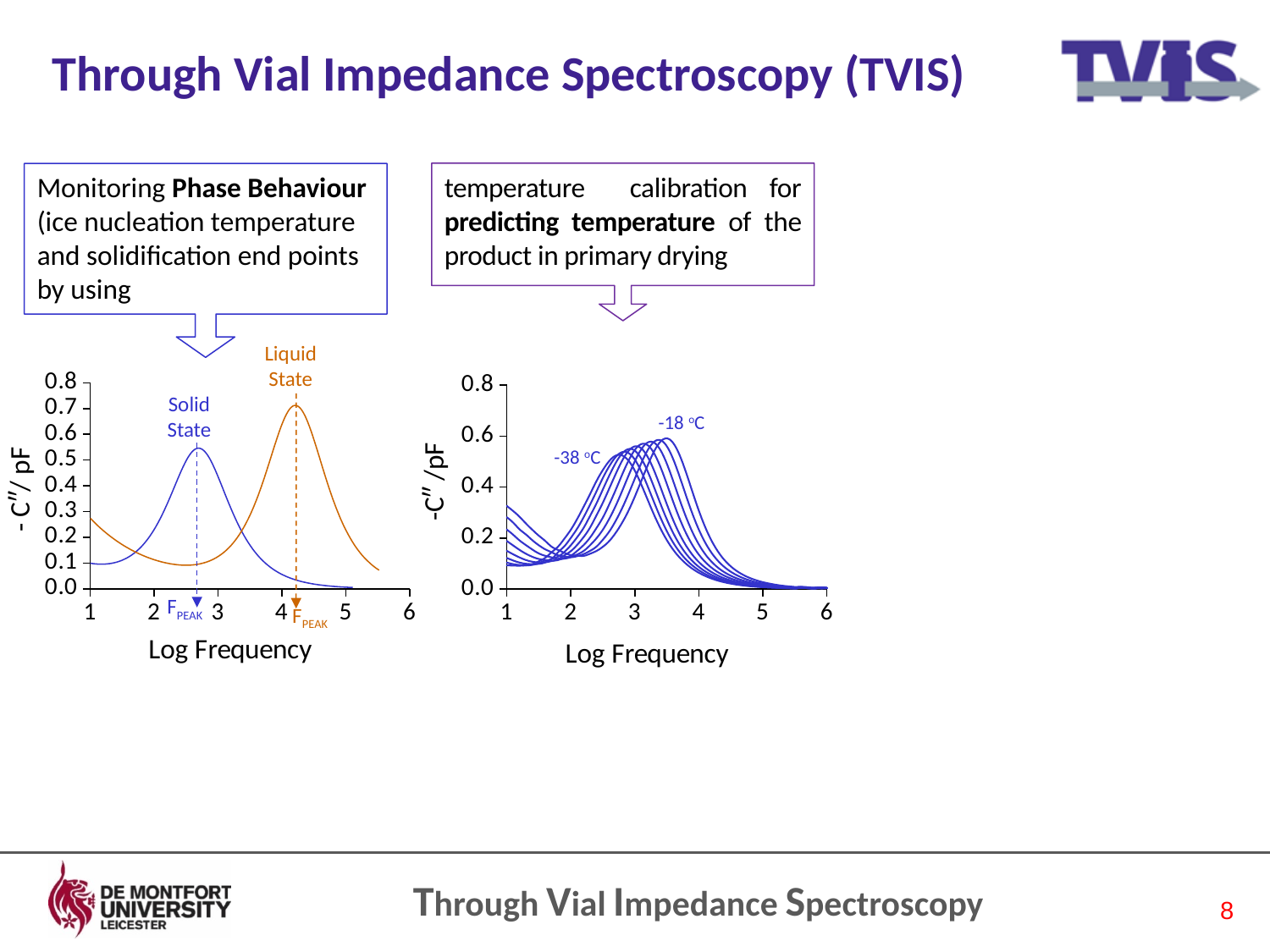
What kind of chart is the right chart (-38 °C to -18 °C)? line chart In the left chart, is the peak value of the Solid State curve greater or less than 0.6? less What two temperatures are labelled on the right chart? -38 °C and -18 °C In the left chart, which curve reaches the higher peak, Solid State or Liquid State? Liquid State In the left chart, is the peak value of the Liquid State curve greater or less than 0.8? less In the left chart, which curve peaks at the lower log frequency, Solid State or Liquid State? Solid State What kind of chart is the left chart (Solid State / Liquid State)? line chart In the left chart, is the peak value of the Liquid State curve greater or less than 0.6? greater In the left chart, at log frequency 1, which curve has the higher value, Solid State or Liquid State? Liquid State What is the x-axis title of the left chart? Log Frequency In the left chart, does the Solid State curve rise or fall as log frequency increases from 3 to 5? fall